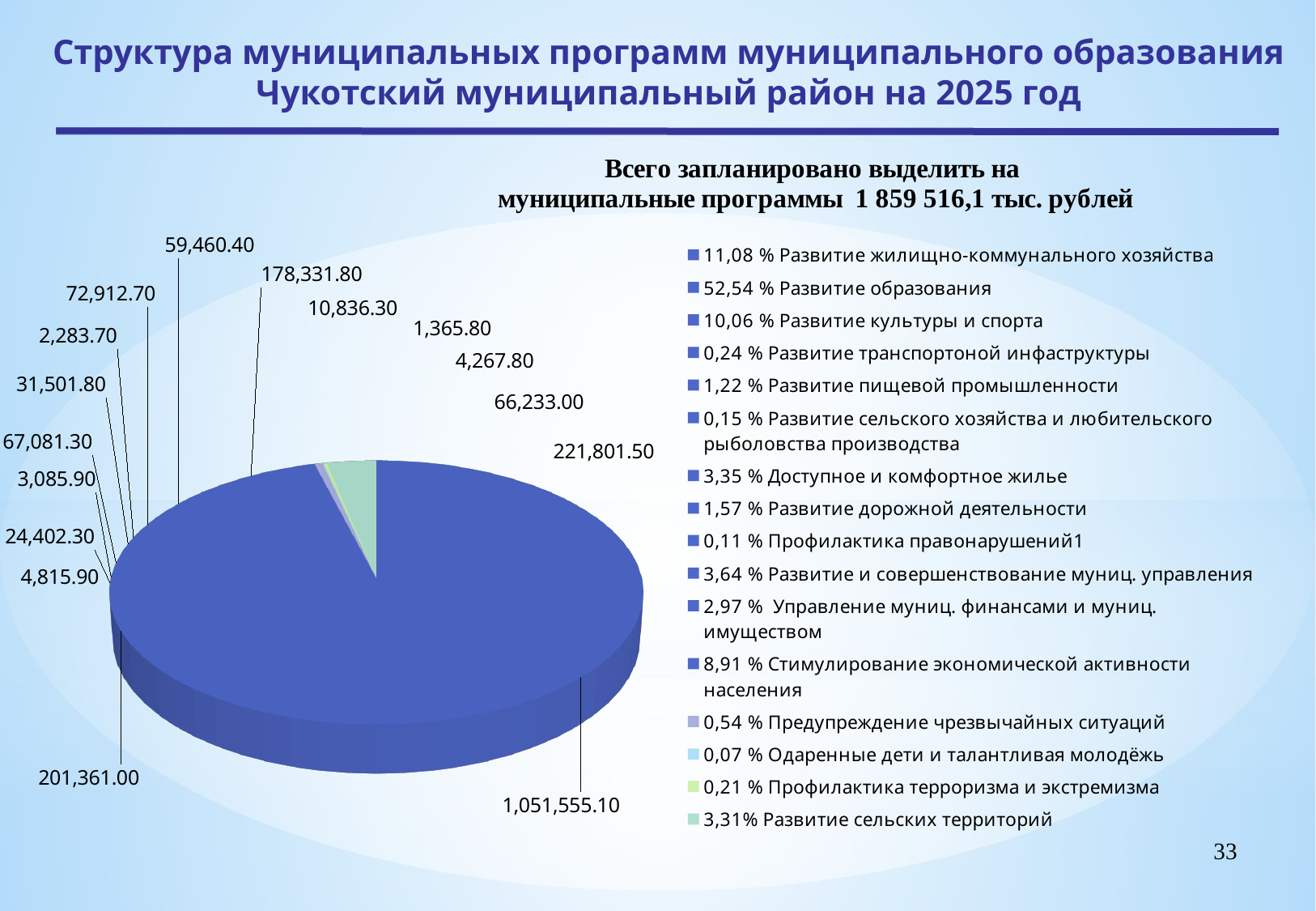
What is the difference between the largest and the smallest values labelled on the pie chart? 1,050,189.30 Which has the larger share: «Развитие культуры и спорта» or «Стимулирование экономической активности населения»? Развитие культуры и спорта What percentage is shown in the legend for «Профилактика терроризма и экстремизма»? 0,21 % According to the legend, what share of the pie does «Развитие образования» have? 52,54 % How many programmes (slices) does the legend of the pie chart list? 16 What is the largest value labelled on the pie chart? 1,051,555.10 What is the smallest value labelled on the pie chart? 1,365.80 What percentage is shown in the legend for «Развитие сельских территорий»? 3,31% Is the share for «Развитие образования» greater or less than 50 %? greater According to the legend, what share of the pie does «Развитие жилищно-коммунального хозяйства» have? 11,08 % According to the text above the chart, what total amount is planned for municipal programmes? 1 859 516,1 тыс. рублей What type of chart is shown on the slide? Pie chart